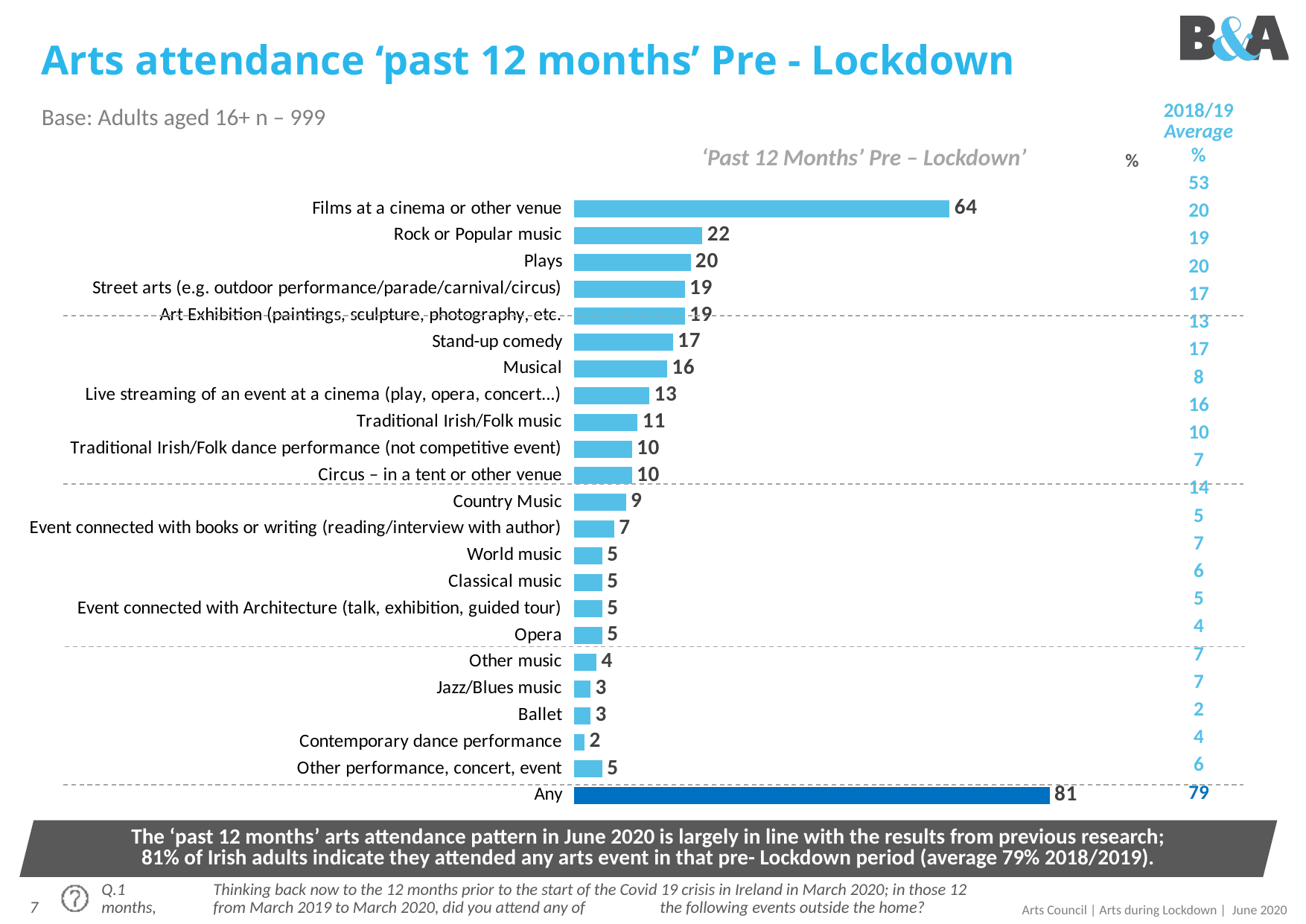
What is the value for Stand-up comedy? 17 What is the value for Country Music? 9 What kind of chart is shown on the slide? Bar chart What is the difference between the value for Any and the value for Films at a cinema or other venue? 17 What is the value for the Any bar? 81 How many bars are plotted in the chart, including the 'Any' bar? 23 What is the title shown above the chart? 'Past 12 Months' Pre – Lockdown' What is the difference between the values for Films at a cinema or other venue and Rock or Popular music? 42 Which is larger, the value for Musical or the value for Live streaming of an event at a cinema? Musical Which category has the lowest value? Contemporary dance performance Excluding the 'Any' bar, which category has the highest value? Films at a cinema or other venue What is the value for Films at a cinema or other venue? 64